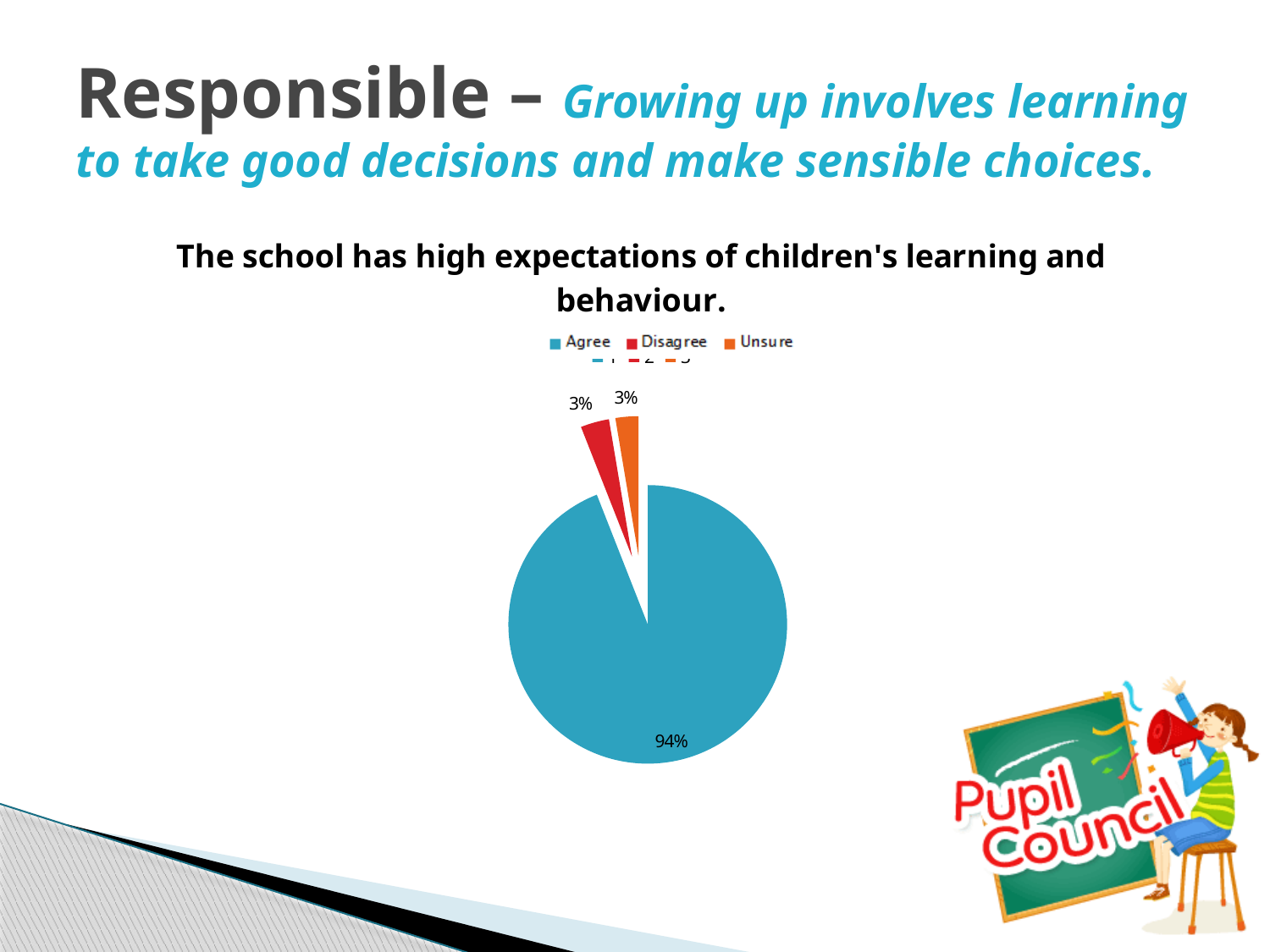
What is the title of the chart? The school has high expectations of children's learning and behaviour. Do the Disagree and Unsure slices have the same share? Yes What percentage of respondents chose Agree? 94% What percentage of respondents chose Disagree? 3% Which response has the largest share of the pie? Agree How many slices does the pie chart have? 3 Which is larger, the share for Agree or the share for Disagree? Agree What percentage of respondents chose Unsure? 3% What kind of chart is shown on the slide? pie chart How many percentage points larger is the Agree share than the Unsure share? 91 How many entries does the chart legend list? 3 What colour is the Agree slice in the pie chart? Blue